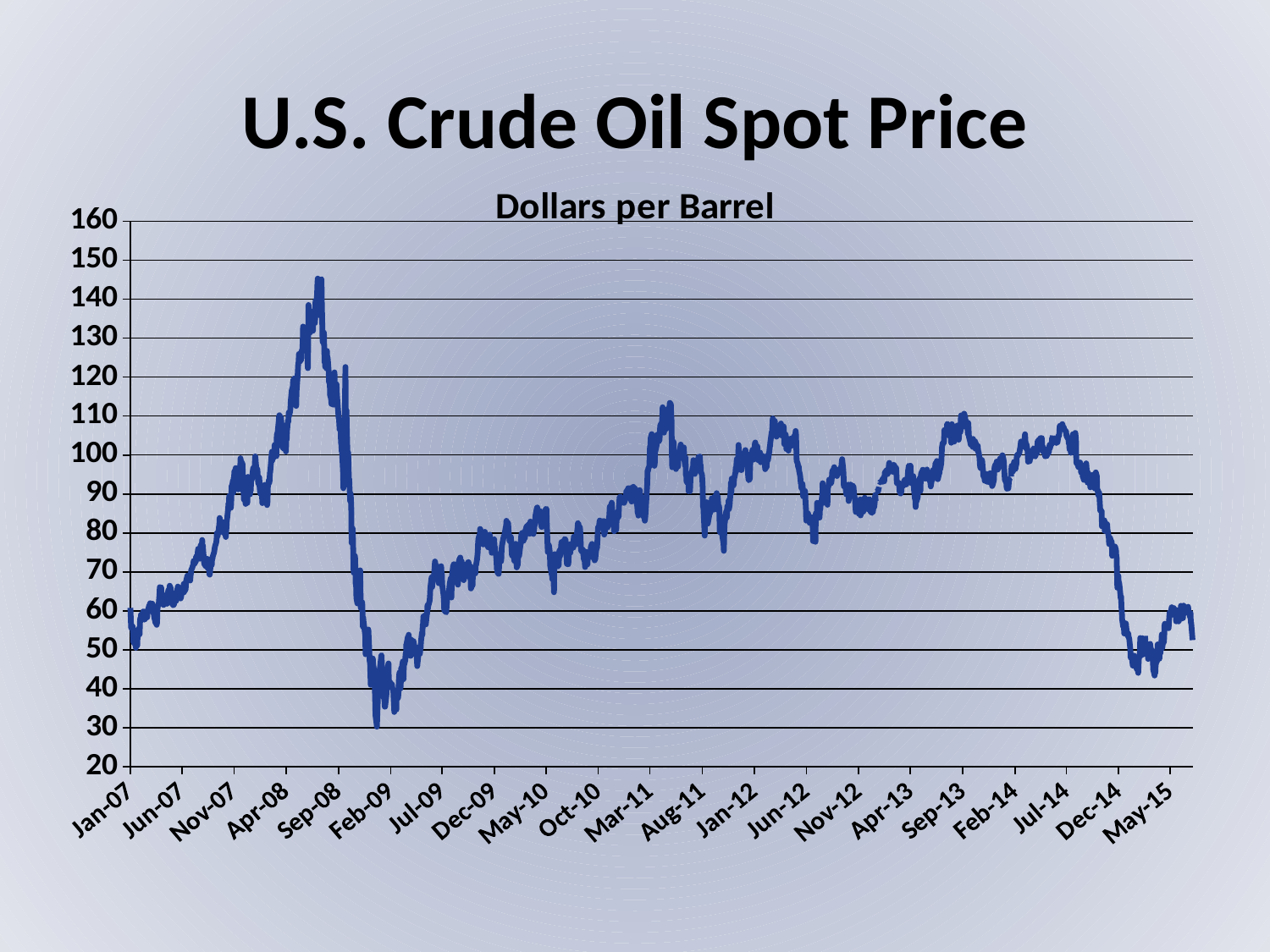
How many date labels are shown on the x axis? 21 Is the crude oil spot price around Sep-13 greater or less than 100? greater Is the lowest value of the crude oil spot price in early 2009 greater or less than 40? less In which year does the crude oil spot price reach its highest point? 2008 What unit is the price measured in, according to the chart subtitle? Dollars per Barrel Does the crude oil spot price rise or fall between Jul-14 and Dec-14? fall What kind of chart is shown on the slide? line chart Is the crude oil spot price at Jan-07 greater or less than 70? less What is the title of the chart? U.S. Crude Oil Spot Price